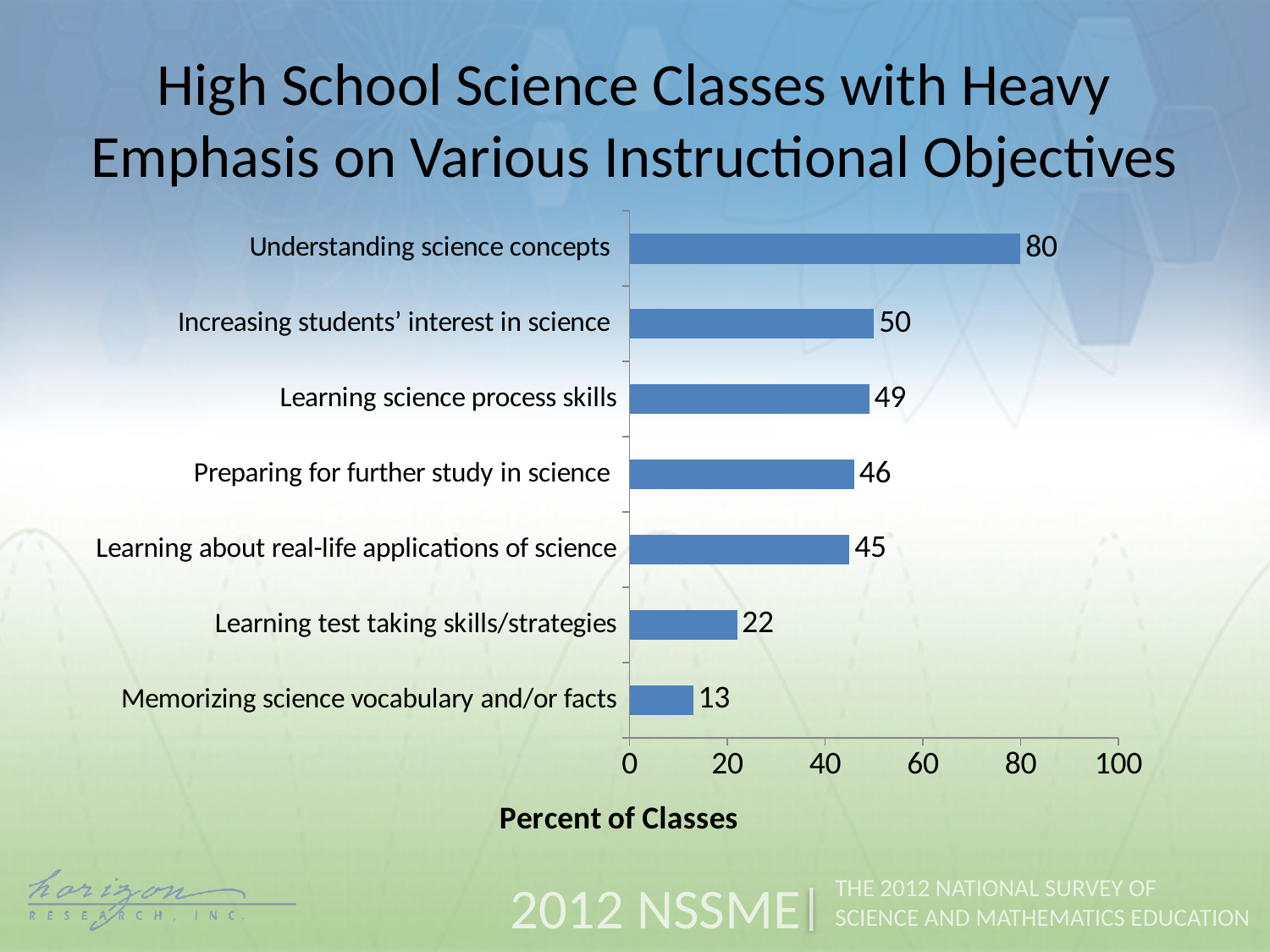
Which instructional objective has the highest percent of classes? Understanding science concepts What is the label of the horizontal axis? Percent of Classes Is the value for learning science process skills greater or less than 40? greater How many instructional objectives are shown in the chart? 7 What is the difference between the values for understanding science concepts and memorizing science vocabulary and/or facts? 67 What is the value for learning test taking skills/strategies? 22 What percent of classes place heavy emphasis on understanding science concepts? 80 What kind of chart is shown on the slide? Bar chart What is the value for preparing for further study in science? 46 Which instructional objective has the lowest percent of classes? Memorizing science vocabulary and/or facts What is the difference between the values for increasing students' interest in science and learning test taking skills/strategies? 28 Which is larger: the value for learning about real-life applications of science or the value for learning test taking skills/strategies? Learning about real-life applications of science